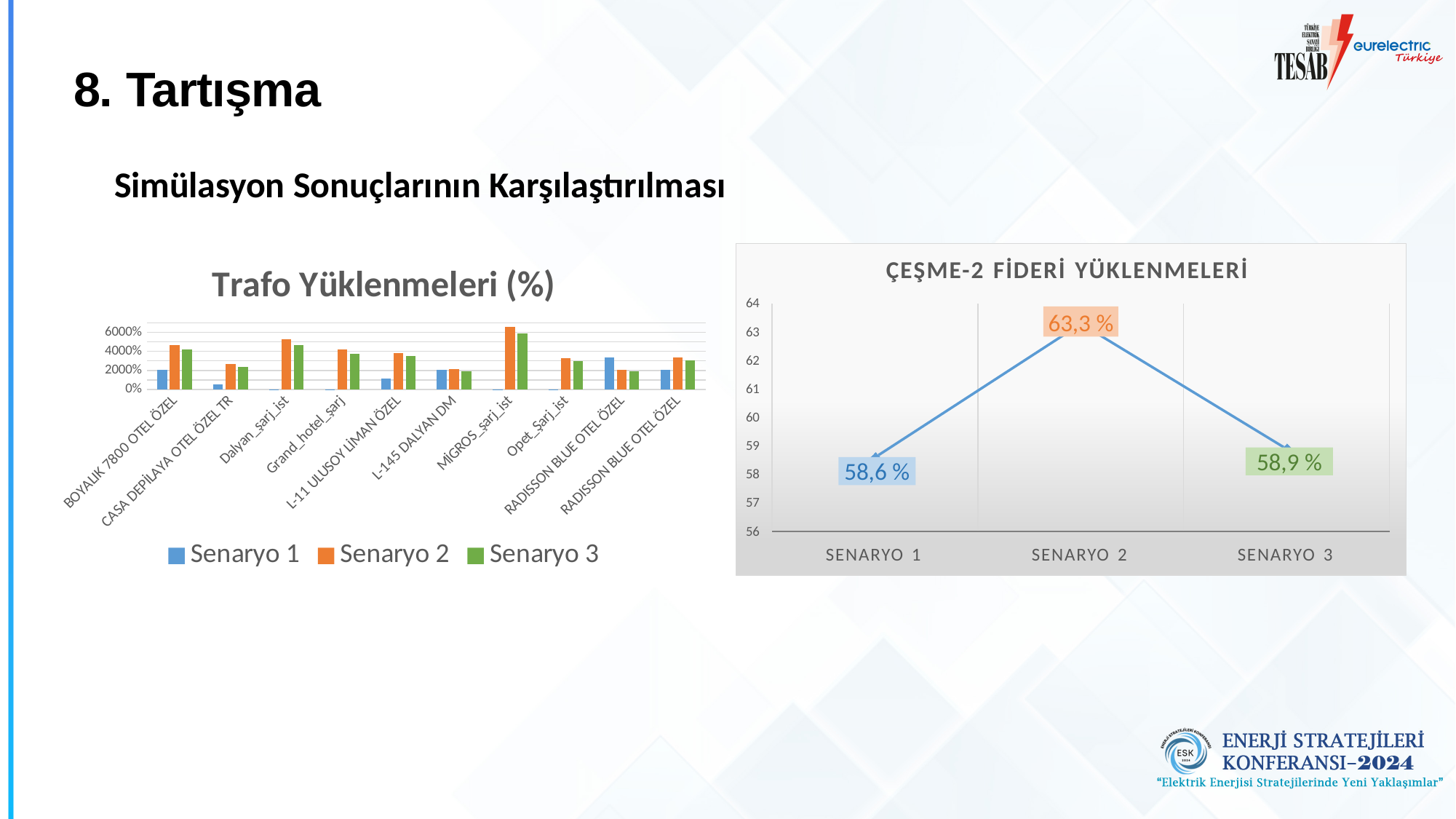
In the Trafo Yüklenmeleri (%) chart, what kind of chart is shown? bar chart In the Trafo Yüklenmeleri (%) chart, is the Senaryo 2 value for Dalyan_şarj_ist greater or less than 4000%? greater In the Trafo Yüklenmeleri (%) chart, which category has the tallest Senaryo 2 bar? MİGROS_şarj_ist In the Trafo Yüklenmeleri (%) chart, how many series does the legend list? 3 In the ÇEŞME-2 FİDERİ YÜKLENMELERİ chart, how many data points are plotted? 3 In the ÇEŞME-2 FİDERİ YÜKLENMELERİ chart, what is the value for SENARYO 1? 58,6 % In the ÇEŞME-2 FİDERİ YÜKLENMELERİ chart, which scenario has the highest value? SENARYO 2 In the ÇEŞME-2 FİDERİ YÜKLENMELERİ chart, what is the value for SENARYO 3? 58,9 % In the ÇEŞME-2 FİDERİ YÜKLENMELERİ chart, what is the value for SENARYO 2? 63,3 % In the ÇEŞME-2 FİDERİ YÜKLENMELERİ chart, what is the difference between the values for SENARYO 2 and SENARYO 1? 4,7 % In the ÇEŞME-2 FİDERİ YÜKLENMELERİ chart, what kind of chart is shown? line chart In the ÇEŞME-2 FİDERİ YÜKLENMELERİ chart, which scenario has the lowest value? SENARYO 1